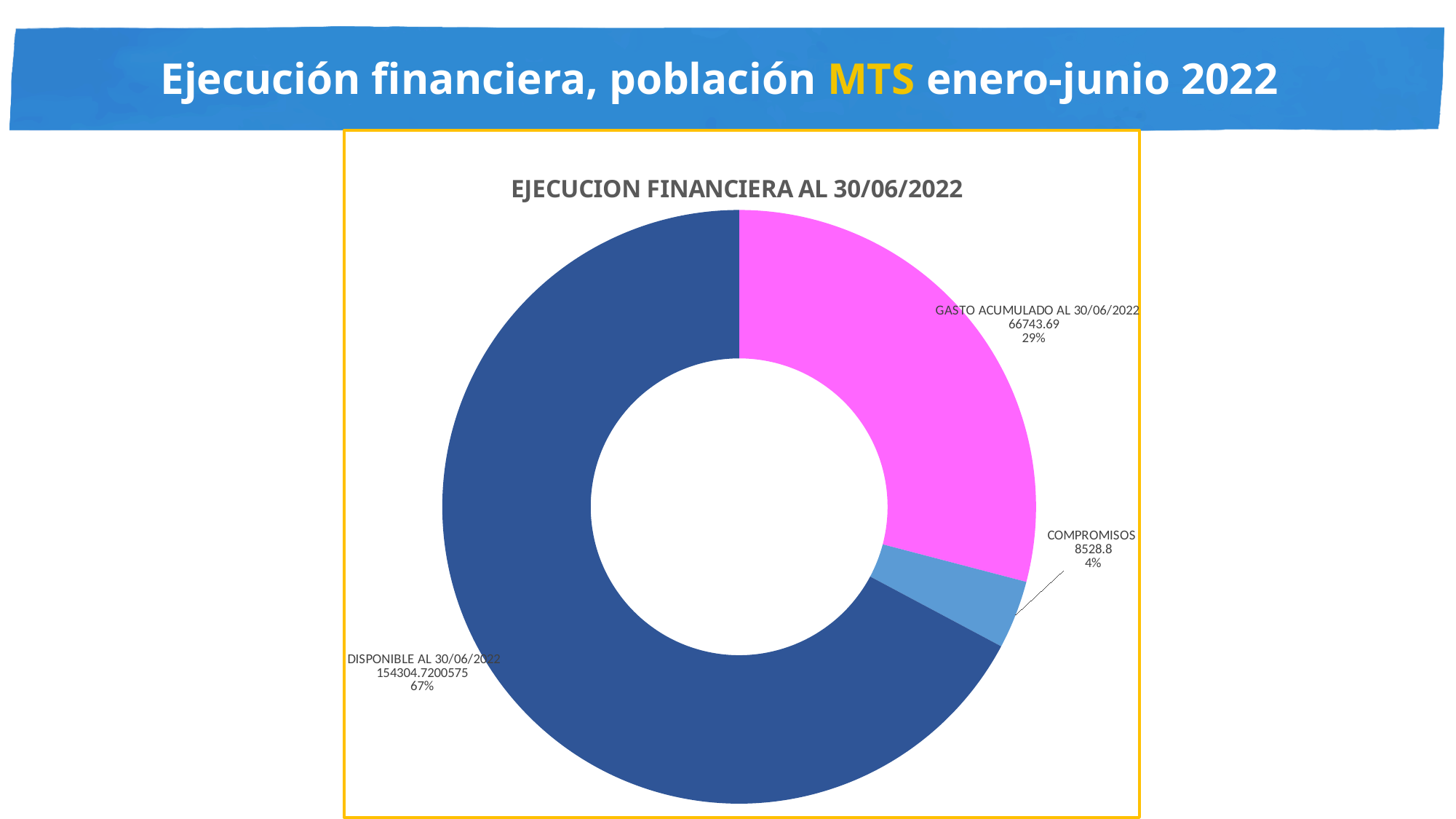
What share of the chart does DISPONIBLE AL 30/06/2022 represent? 67% What share of the chart does COMPROMISOS represent? 4% Which is larger, GASTO ACUMULADO AL 30/06/2022 or COMPROMISOS? GASTO ACUMULADO AL 30/06/2022 What is the value for DISPONIBLE AL 30/06/2022? 154304.7200575 Which category has the smallest slice? COMPROMISOS Which category has the largest slice? DISPONIBLE AL 30/06/2022 What type of chart is shown? Pie chart (doughnut) How many categories are shown in the chart? 3 What is the value for COMPROMISOS? 8528.8 What is the value for GASTO ACUMULADO AL 30/06/2022? 66743.69 What is the difference between the values for GASTO ACUMULADO AL 30/06/2022 and COMPROMISOS? 58214.89 What share of the chart does GASTO ACUMULADO AL 30/06/2022 represent? 29%